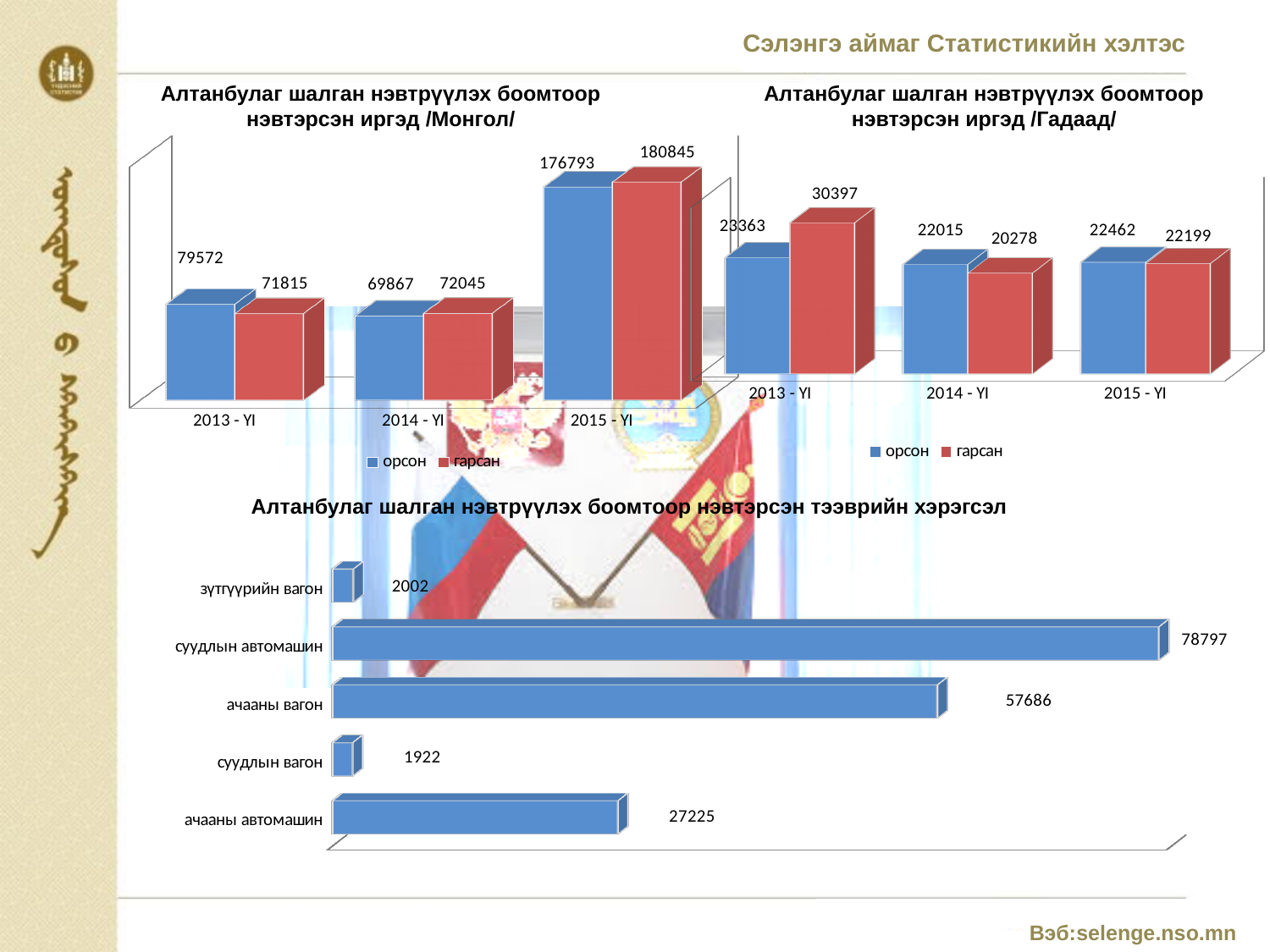
In the top-left chart (Монгол), what is the value of орсон for 2015 - YI? 176793 In the top-left chart (Монгол), what is the value of гарсан for 2013 - YI? 71815 How many series does the legend of the top-right chart (Гадаад) list? 2 In the bottom chart (тээврийн хэрэгсэл), what is the value for суудлын автомашин? 78797 In the top-left chart (Монгол), which year has the highest орсон value? 2015 - YI In the top-right chart (Гадаад), what is the difference between гарсан and орсон for 2013 - YI? 7034 In the top-left chart (Монгол), what is the difference between гарсан and орсон for 2015 - YI? 4052 In the top-right chart (Гадаад), which is larger for 2014 - YI, орсон or гарсан? орсон What type of chart is the bottom chart (тээврийн хэрэгсэл)? bar chart How many categories are shown in the bottom chart (тээврийн хэрэгсэл)? 5 In the bottom chart (тээврийн хэрэгсэл), which category has the lowest value? суудлын вагон In the top-right chart (Гадаад), what is the value of гарсан for 2013 - YI? 30397